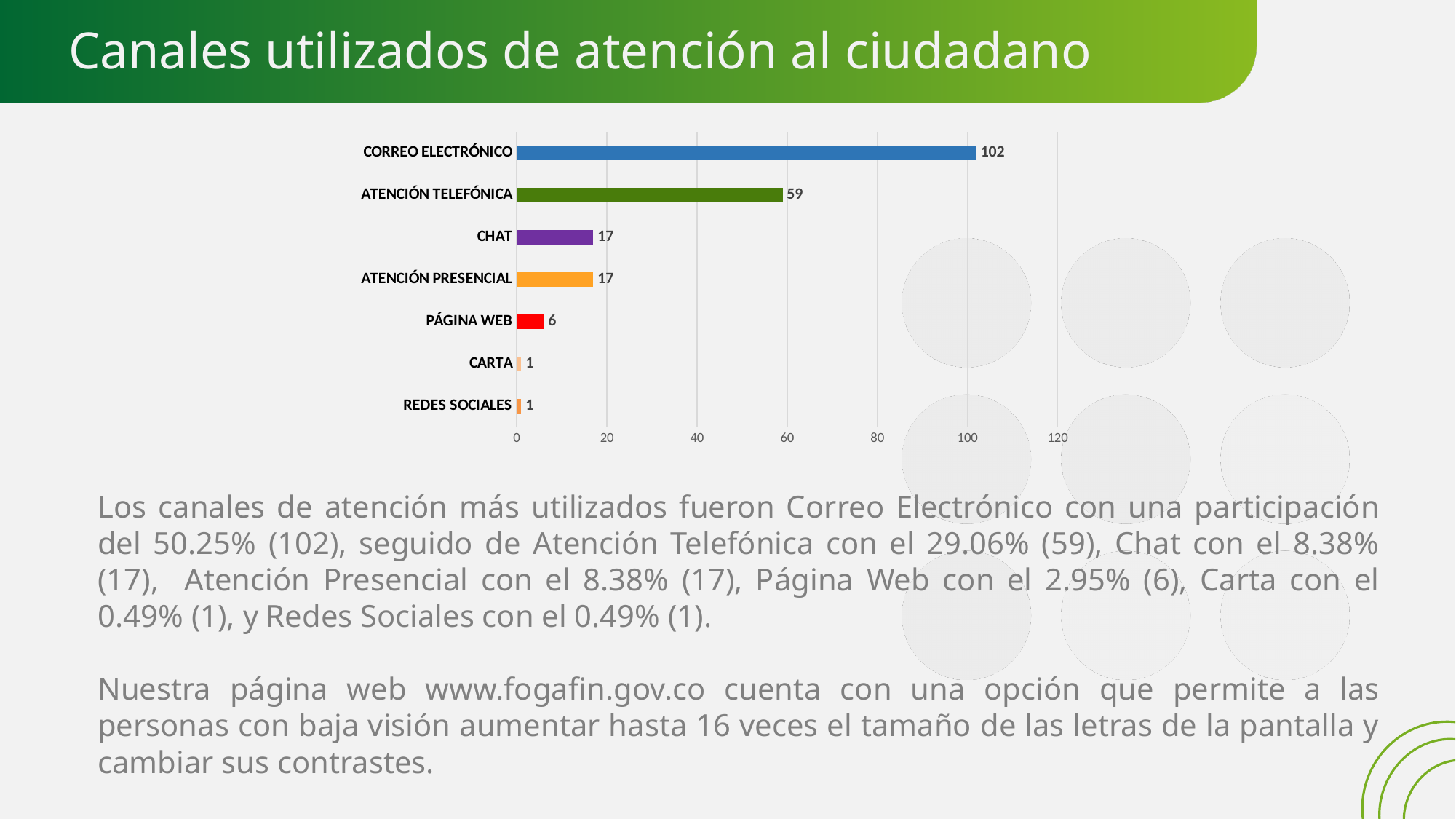
What is the difference between the values for ATENCIÓN PRESENCIAL and PÁGINA WEB? 11 What is the value for CORREO ELECTRÓNICO? 102 What is the value for CARTA? 1 How many categories are shown in the chart? 7 What is the value for PÁGINA WEB? 6 What is the value for ATENCIÓN TELEFÓNICA? 59 Which category has the highest value? CORREO ELECTRÓNICO Which is larger, the value for CHAT or the value for PÁGINA WEB? CHAT Is the value for ATENCIÓN TELEFÓNICA greater or less than 40? greater What kind of chart is shown on the slide? Bar chart What colour is the bar for CHAT? Purple What is the difference between the values for CORREO ELECTRÓNICO and ATENCIÓN TELEFÓNICA? 43